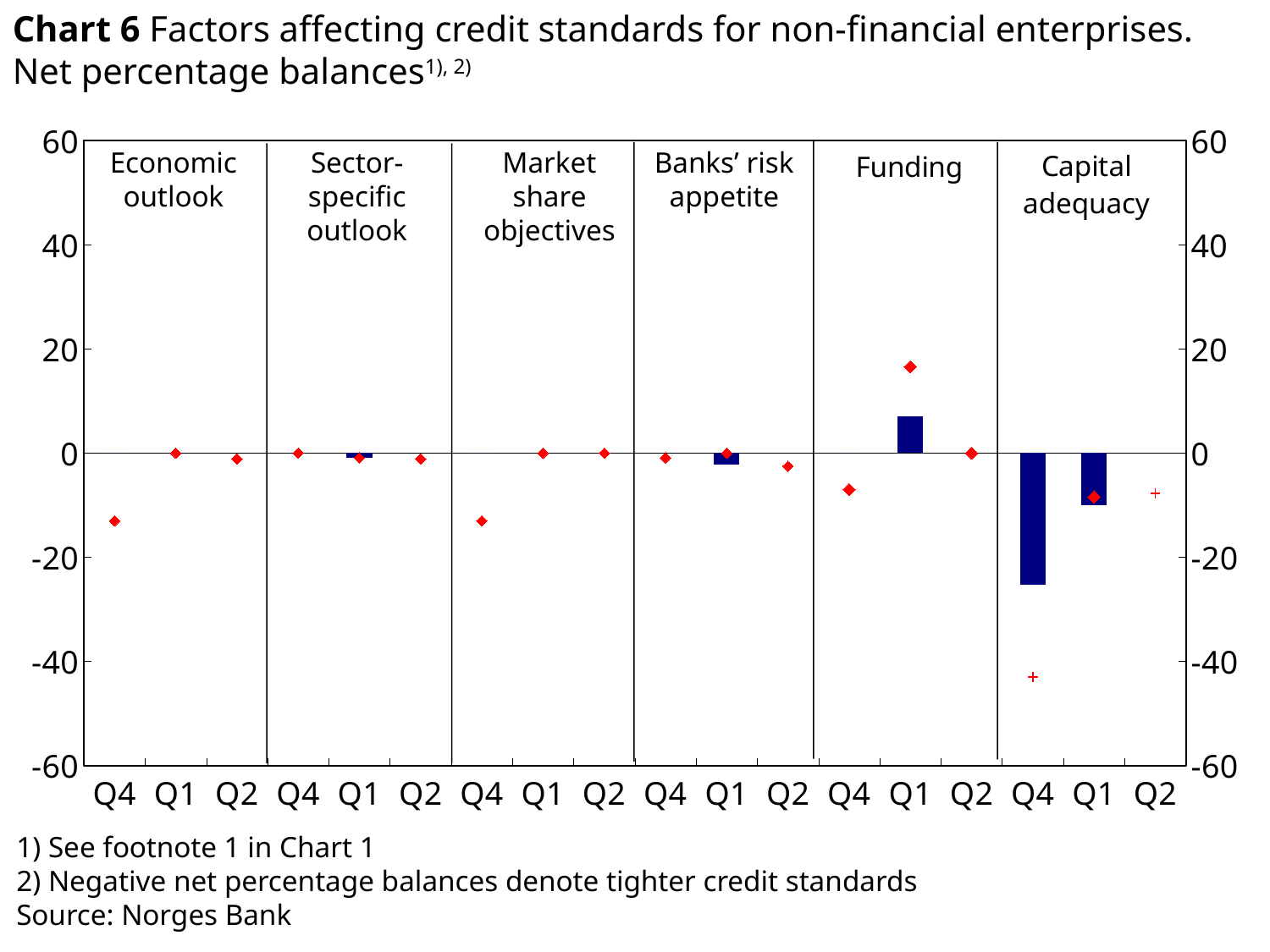
How many quarters are shown within each panel of the chart? 3 Is the Q4 plus marker for Capital adequacy greater or less than -40? less Which factor has the only bar above zero in the chart? Funding Which factor and quarter has the lowest (most negative) bar in the chart? Capital adequacy, Q4 What is the source cited for the chart? Norges Bank In the Capital adequacy panel, which bar is lower, Q4 or Q1? Q4 How many factors (panels) are shown in the chart? 6 What kind of chart is shown on the slide? bar chart Is the Q1 diamond marker for Funding greater or less than 20? less Is the Q1 bar for Funding greater or less than 0? greater